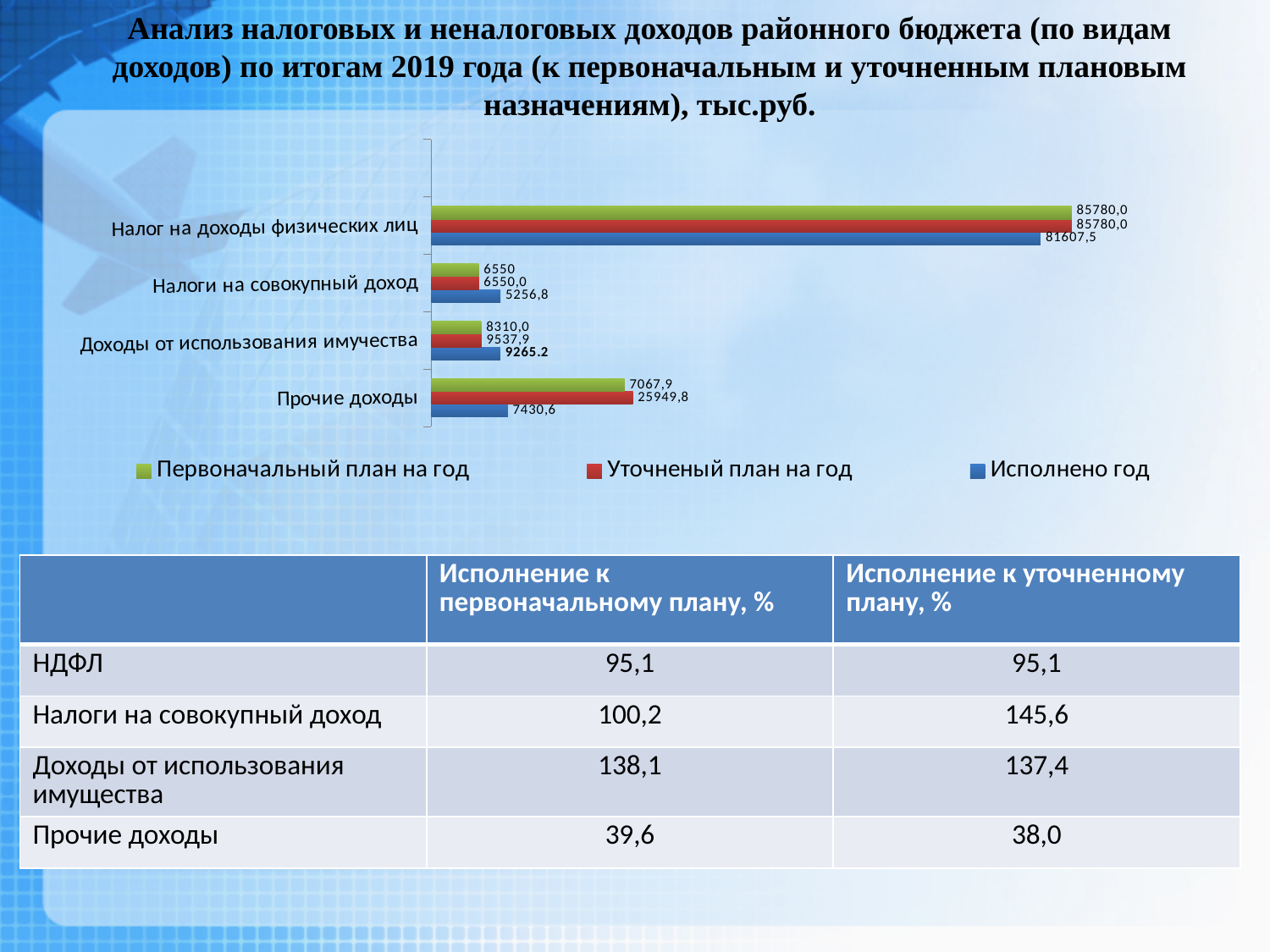
How many series does the chart legend list? 3 Which colour represents the "Исполнено год" series in the chart? blue What is the value of "Первоначальный план на год" for "Доходы от использования имучества"? 8310,0 What kind of chart is shown on the slide? bar chart For "Доходы от использования имучества", which is larger: "Уточненый план на год" or "Первоначальный план на год"? Уточненый план на год What is the value of "Исполнено год" for "Налоги на совокупный доход"? 5256,8 What is the difference between "Уточненый план на год" and "Исполнено год" for "Прочие доходы"? 18519,2 What is the value of "Исполнено год" for "Налог на доходы физических лиц"? 81607,5 Which category has the lowest value for "Первоначальный план на год"? Налоги на совокупный доход How many categories are plotted on the chart? 4 Which category has the highest value for "Исполнено год"? Налог на доходы физических лиц What is the value of "Уточненый план на год" for "Прочие доходы"? 25949,8